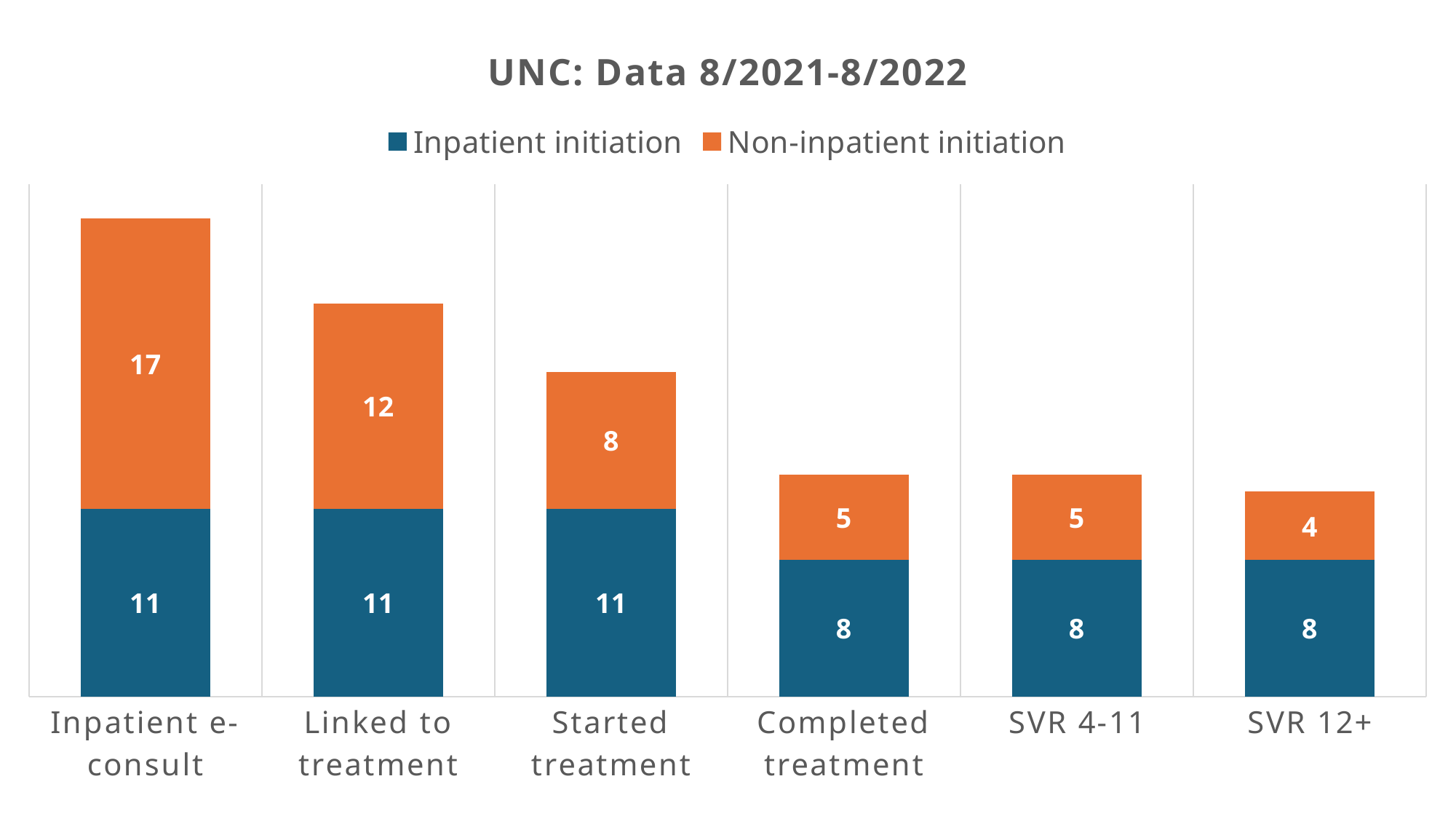
How many categories are shown on the x axis? 6 How many series does the legend list? 2 What is the Inpatient initiation value for Completed treatment? 8 What is the difference between the Non-inpatient initiation values for Inpatient e-consult and Linked to treatment? 5 What is the total of the stacked bar for SVR 4-11? 13 What is the Non-inpatient initiation value for SVR 12+? 4 What is the total of the stacked bar for Inpatient e-consult? 28 Which category has the lowest Non-inpatient initiation value? SVR 12+ What is the Non-inpatient initiation value for Inpatient e-consult? 17 Which is larger: the Inpatient initiation value for Started treatment or the Non-inpatient initiation value for Started treatment? Inpatient initiation What type of chart is shown? Stacked bar chart Which category has the highest Non-inpatient initiation value? Inpatient e-consult